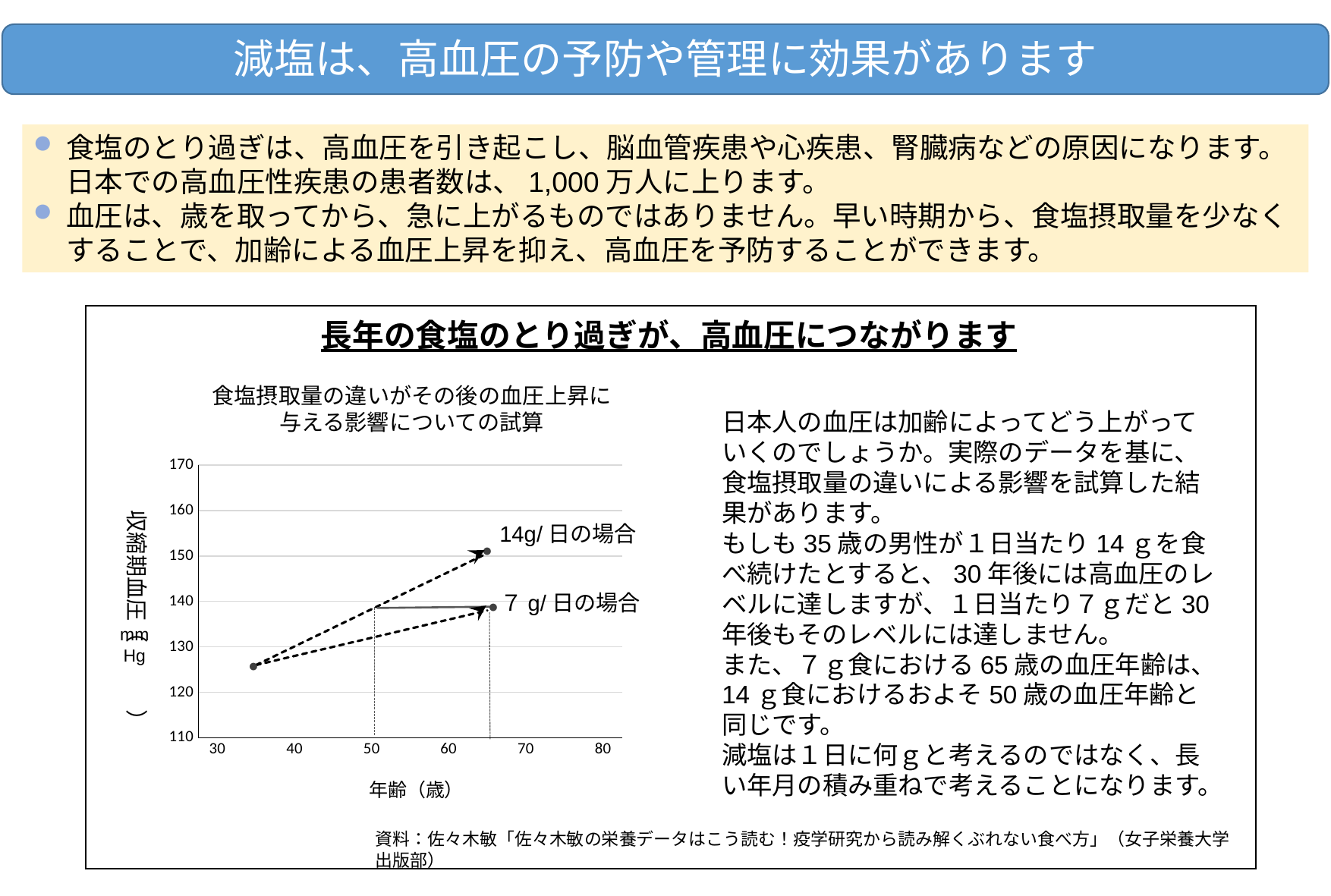
Does systolic blood pressure rise or fall with age for the 7 g/日の場合 line? rise Is the systolic blood pressure for 7 g/日の場合 at age 65 greater or less than 130? greater Is the systolic blood pressure for 14g/日の場合 at age 65 greater or less than 140? greater What is the label of the x axis of the chart? 年齢（歳） Does systolic blood pressure rise or fall with age for the 14g/日の場合 line? rise What is the title of the chart? 食塩摂取量の違いがその後の血圧上昇に与える影響についての試算 At age 65, which scenario shows the higher systolic blood pressure, 14g/日の場合 or 7 g/日の場合? 14g/日の場合 Is the systolic blood pressure at the starting age of 35 greater or less than 120? greater What is the highest value shown on the y axis of the chart? 170 How many salt-intake scenarios (series) are plotted on the chart? 2 What kind of chart is shown on the slide? line chart